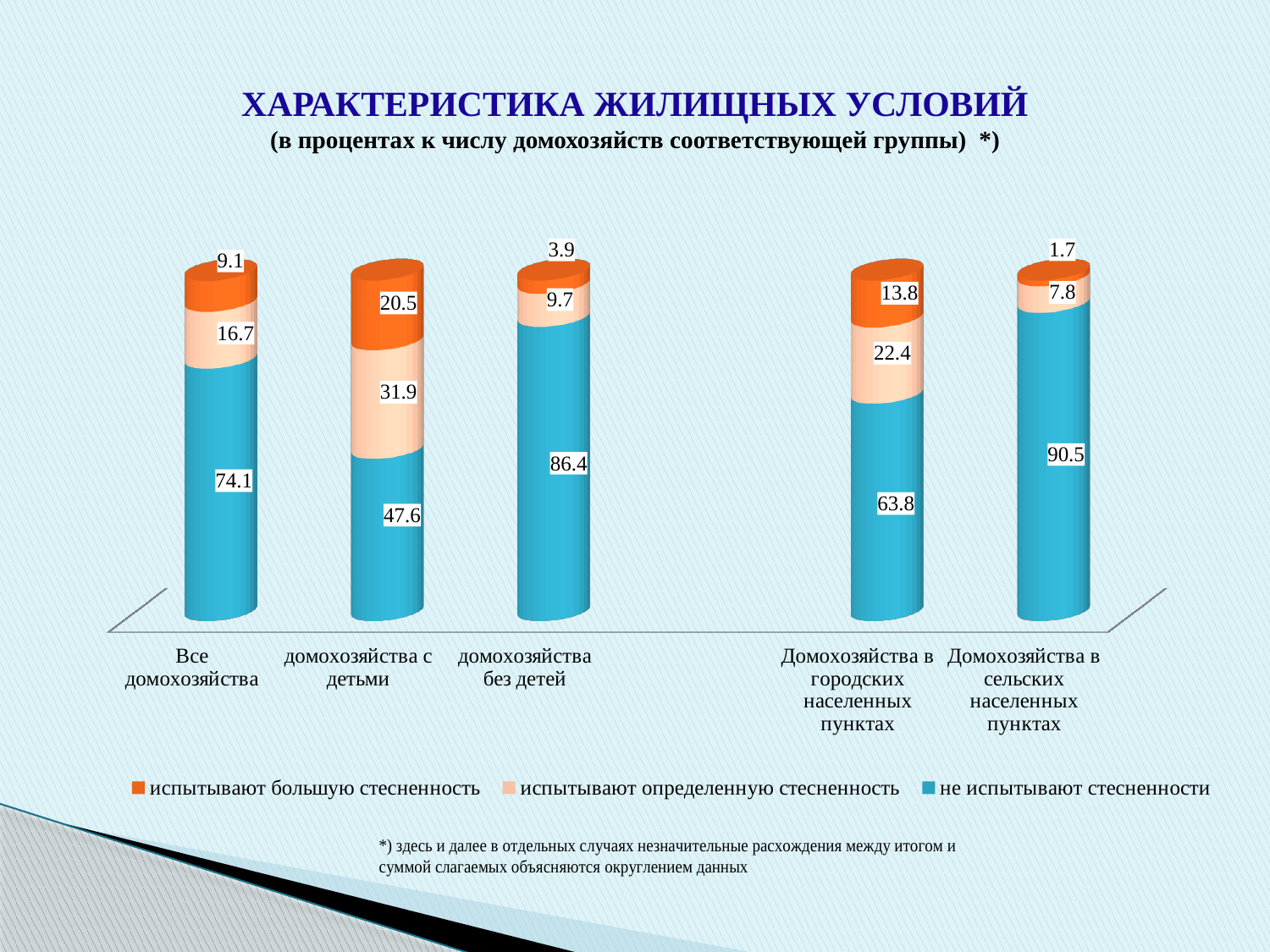
Which category has the lowest value for "испытывают большую стесненность"? Домохозяйства в сельских населенных пунктах Which colour represents "не испытывают стесненности" in the legend? Blue What is the difference between the "не испытывают стесненности" values for "домохозяйства без детей" and "домохозяйства с детьми"? 38.8 Which is larger: the "испытывают определенную стесненность" value for "Домохозяйства в городских населенных пунктах" or for "Домохозяйства в сельских населенных пунктах"? Домохозяйства в городских населенных пунктах What is the total of the stacked bar for "домохозяйства с детьми"? 100.0 What is the value for "не испытывают стесненности" for "домохозяйства с детьми"? 47.6 Which category has the highest value for "не испытывают стесненности"? Домохозяйства в сельских населенных пунктах What is the value for "испытывают определенную стесненность" for "Все домохозяйства"? 16.7 How many series does the legend list? 3 How many categories are shown on the x axis? 5 What is the value for "испытывают большую стесненность" for "Домохозяйства в городских населенных пунктах"? 13.8 What kind of chart is shown on the slide? Stacked bar chart